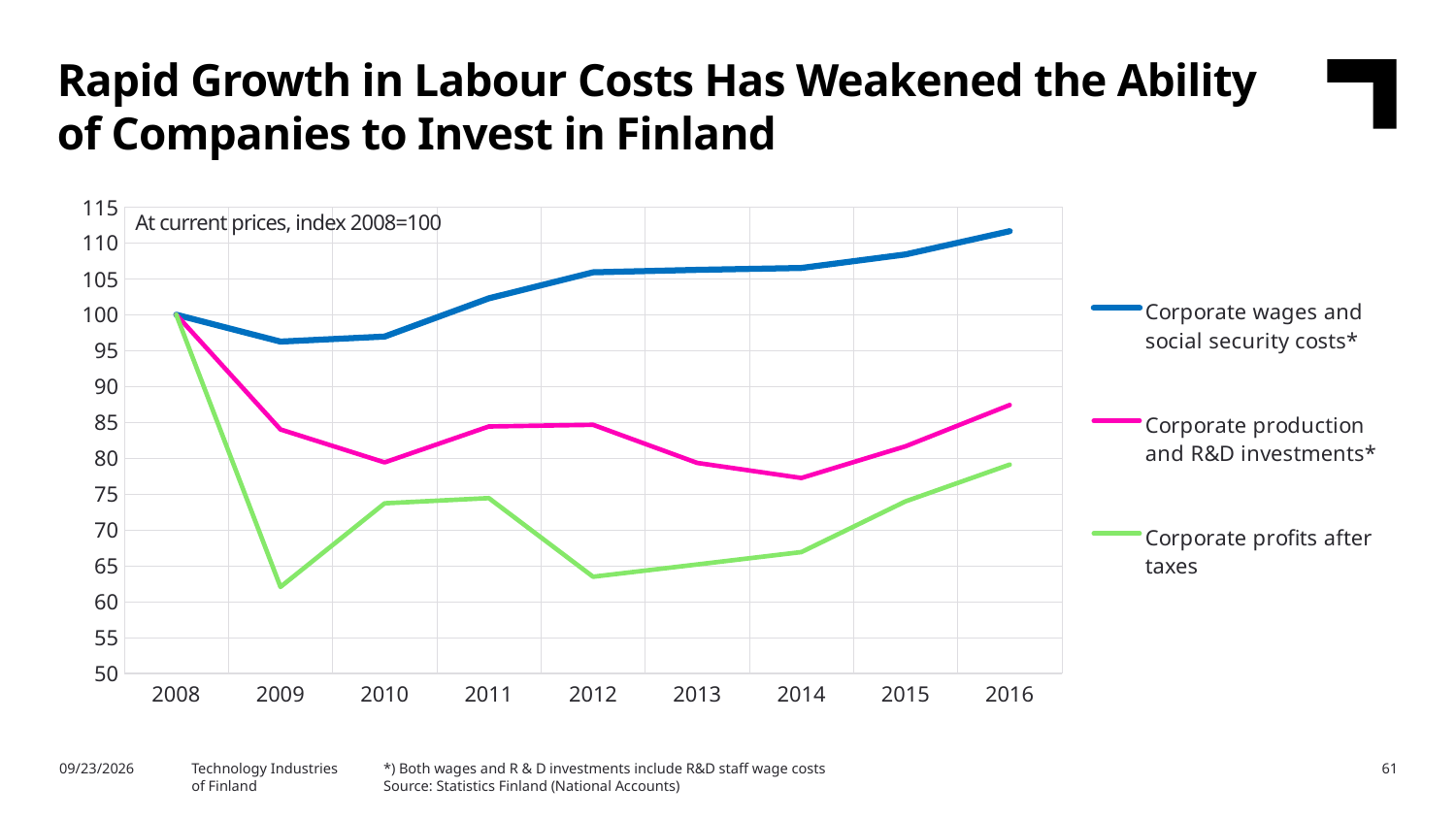
How many years are shown on the x axis? 9 Is the value for Corporate profits after taxes in 2009 greater or less than 65? less What note is printed inside the chart area at the top left? At current prices, index 2008=100 What is the index value for Corporate wages and social security costs* in 2008? 100 Which series has the highest value in 2016? Corporate wages and social security costs* In which year does Corporate profits after taxes reach its lowest value? 2009 Do the values for Corporate wages and social security costs* rise or fall from 2010 to 2016? rise What kind of chart is shown on the slide? Line chart How many series does the legend list? 3 Is the value for Corporate production and R&D investments* in 2014 greater or less than 80? less Is the value for Corporate wages and social security costs* in 2016 greater or less than 110? greater In 2012, which is higher: Corporate production and R&D investments* or Corporate profits after taxes? Corporate production and R&D investments*